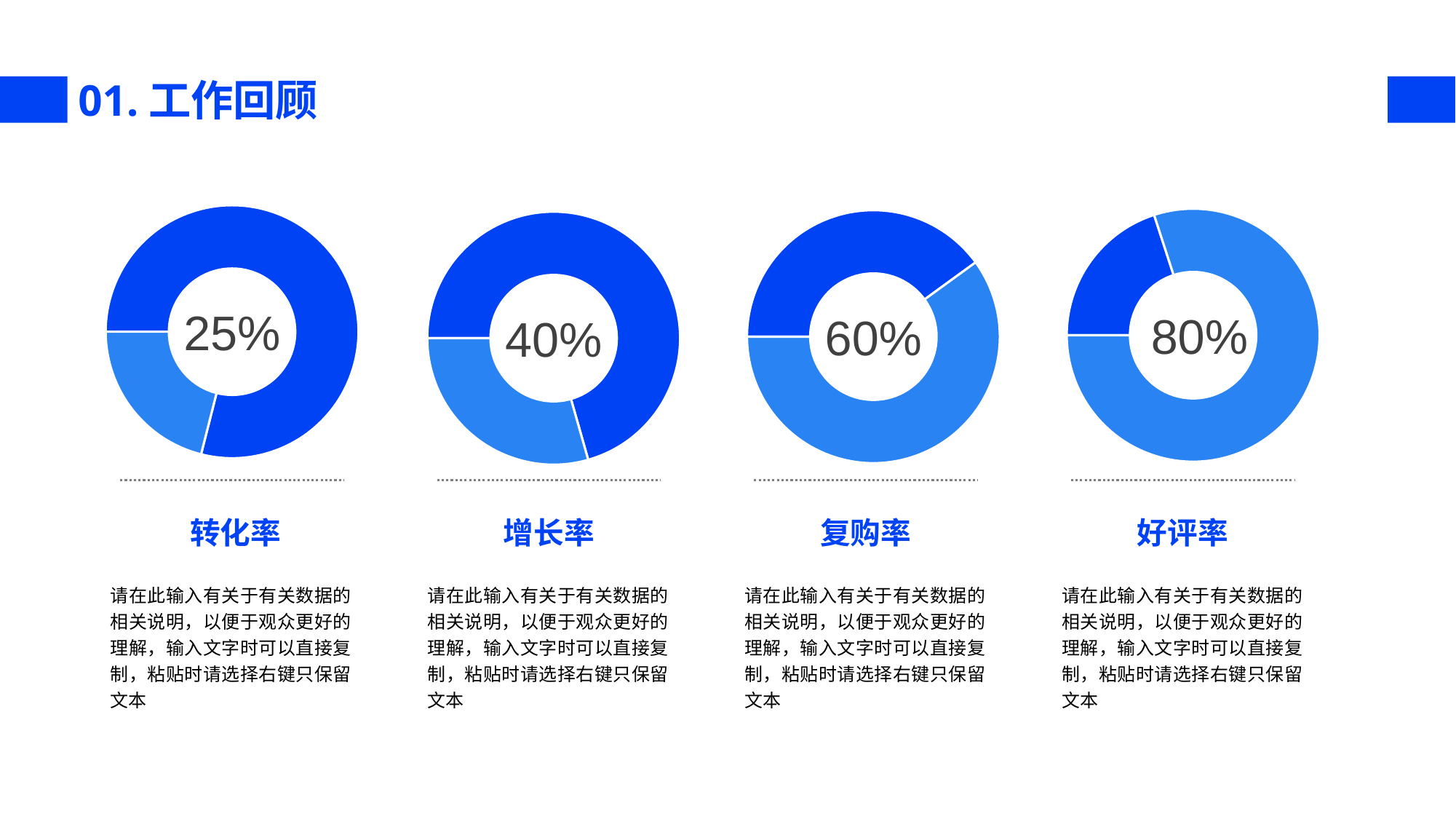
What value is shown in the centre of the 增长率 donut chart? 40% What value is shown in the centre of the 好评率 donut chart? 80% Which is larger, the 增长率 value or the 复购率 value? 复购率 What is the difference between the 复购率 value and the 增长率 value? 20% How many donut charts are shown on the slide? 4 What value is shown in the centre of the 转化率 donut chart? 25% Which of the four donut charts shows the lowest percentage? 转化率 In the 好评率 donut chart, which colour fills the larger portion of the ring, light blue or dark blue? Light blue What value is shown in the centre of the 复购率 donut chart? 60% Which of the four donut charts shows the highest percentage? 好评率 What is the difference between the 好评率 value and the 转化率 value? 55% What kind of chart is used for the 转化率 figure? Donut (pie) chart